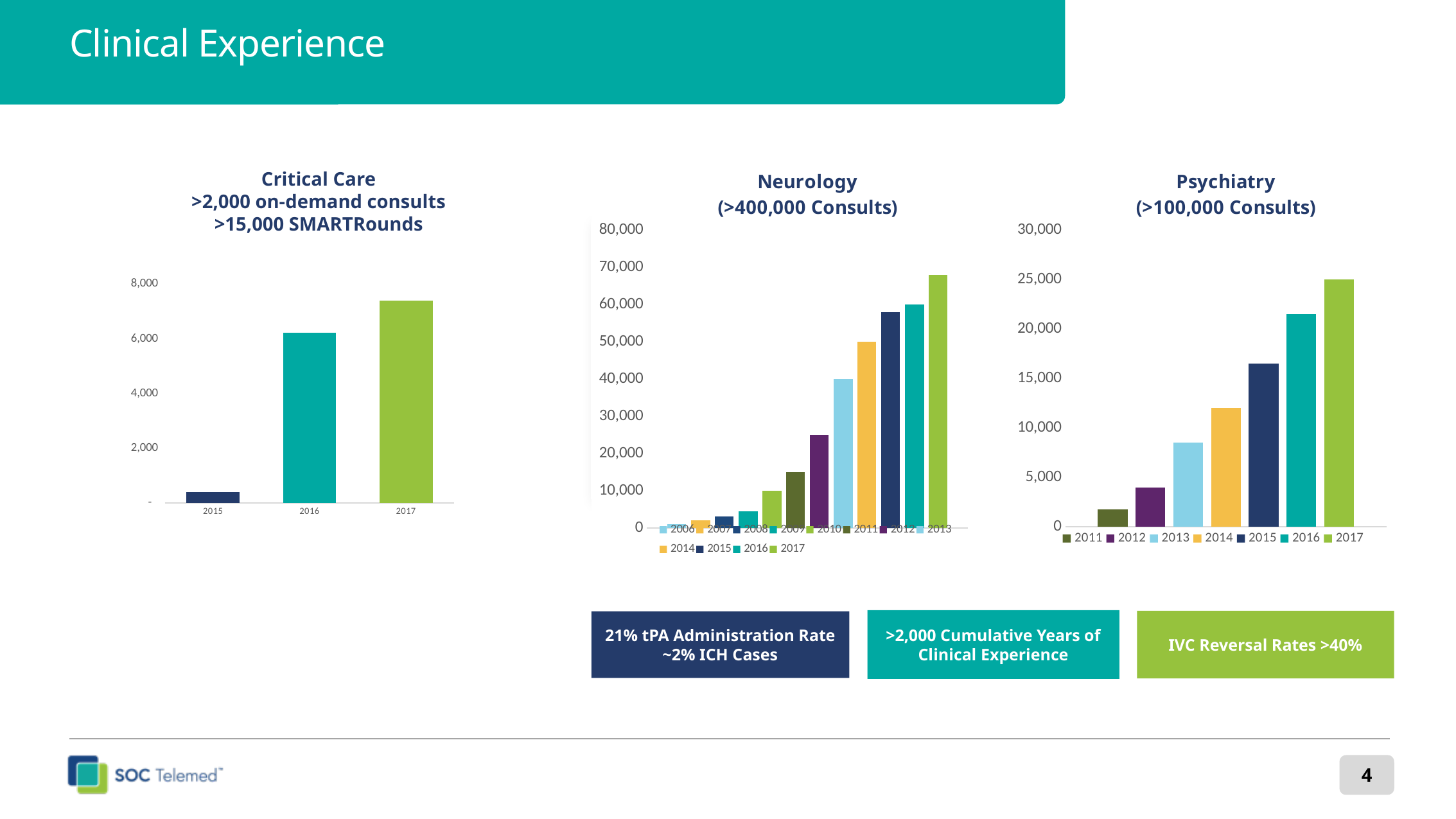
In the Critical Care chart, is the value for 2016 greater or less than 6,000? greater In the Psychiatry chart, is the value for 2016 greater or less than 20,000? greater In the Critical Care chart, which year has the highest value? 2017 In the Critical Care chart, which year has the lowest value? 2015 What kind of chart is the Critical Care chart? bar chart In the Psychiatry chart, which is larger, the value for 2014 or the value for 2013? 2014 In the Neurology chart, do the values rise or fall from 2006 to 2017? rise How many charts are on the slide? 3 In the Neurology chart, is the value for 2012 greater or less than 20,000? greater In the Psychiatry chart, which year has the highest value? 2017 How many bars does the Neurology chart show? 12